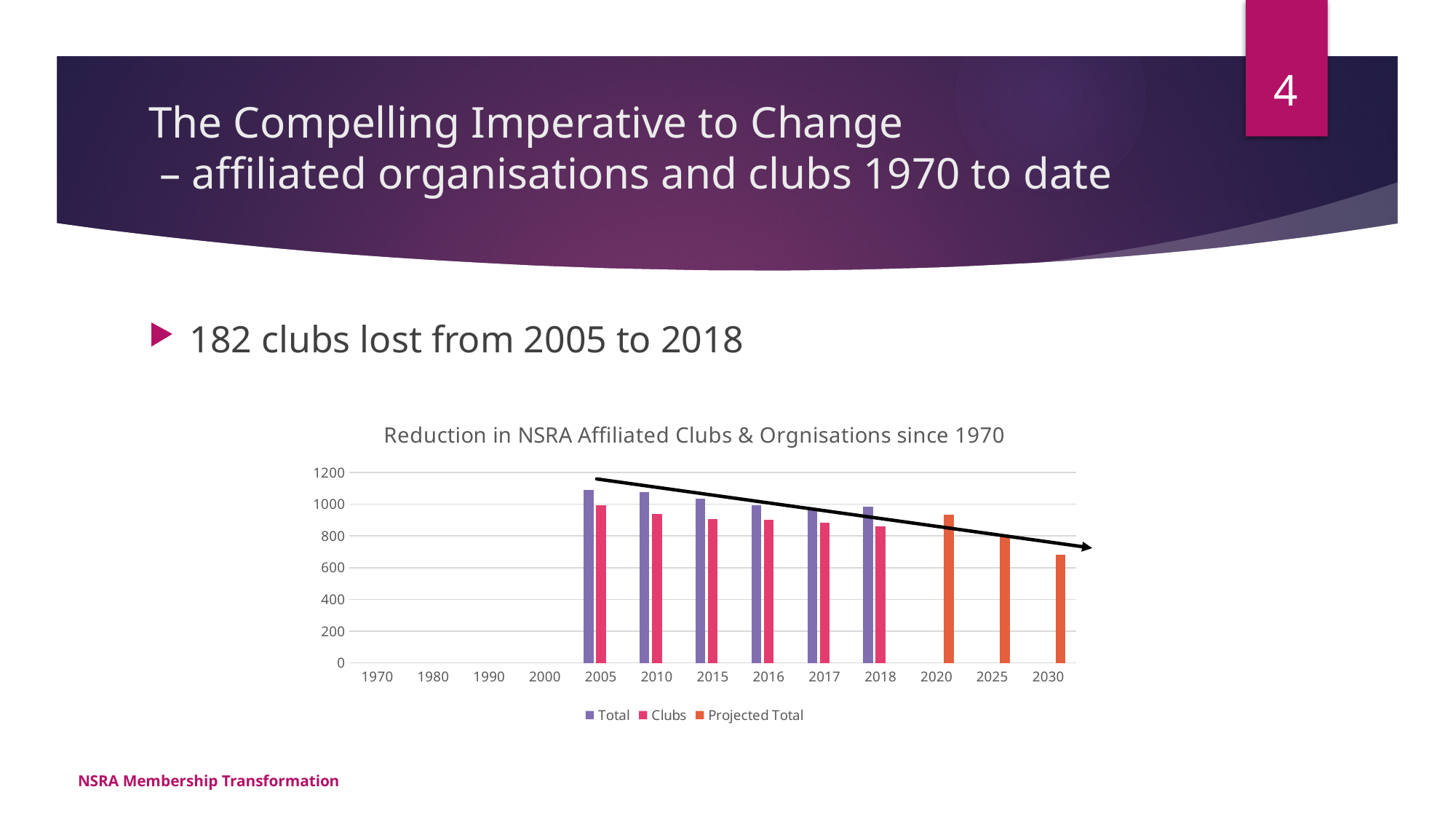
In which year is the Total series highest? 2005 Is the Total value for 2005 greater or less than 1000? greater In which year is the Projected Total series lowest? 2030 How many year categories are shown on the x axis of the chart? 13 What kind of chart is shown on the slide? bar chart Do the Total values rise or fall from 2005 to 2018? fall Is the Clubs value for 2010 greater or less than 1000? less How many series does the chart legend list? 3 Which is larger, the Total value for 2005 or the Total value for 2018? 2005 What is the title of the chart? Reduction in NSRA Affiliated Clubs & Orgnisations since 1970 Which series is shown in orange in the chart? Projected Total Is the Projected Total value for 2030 greater or less than 800? less